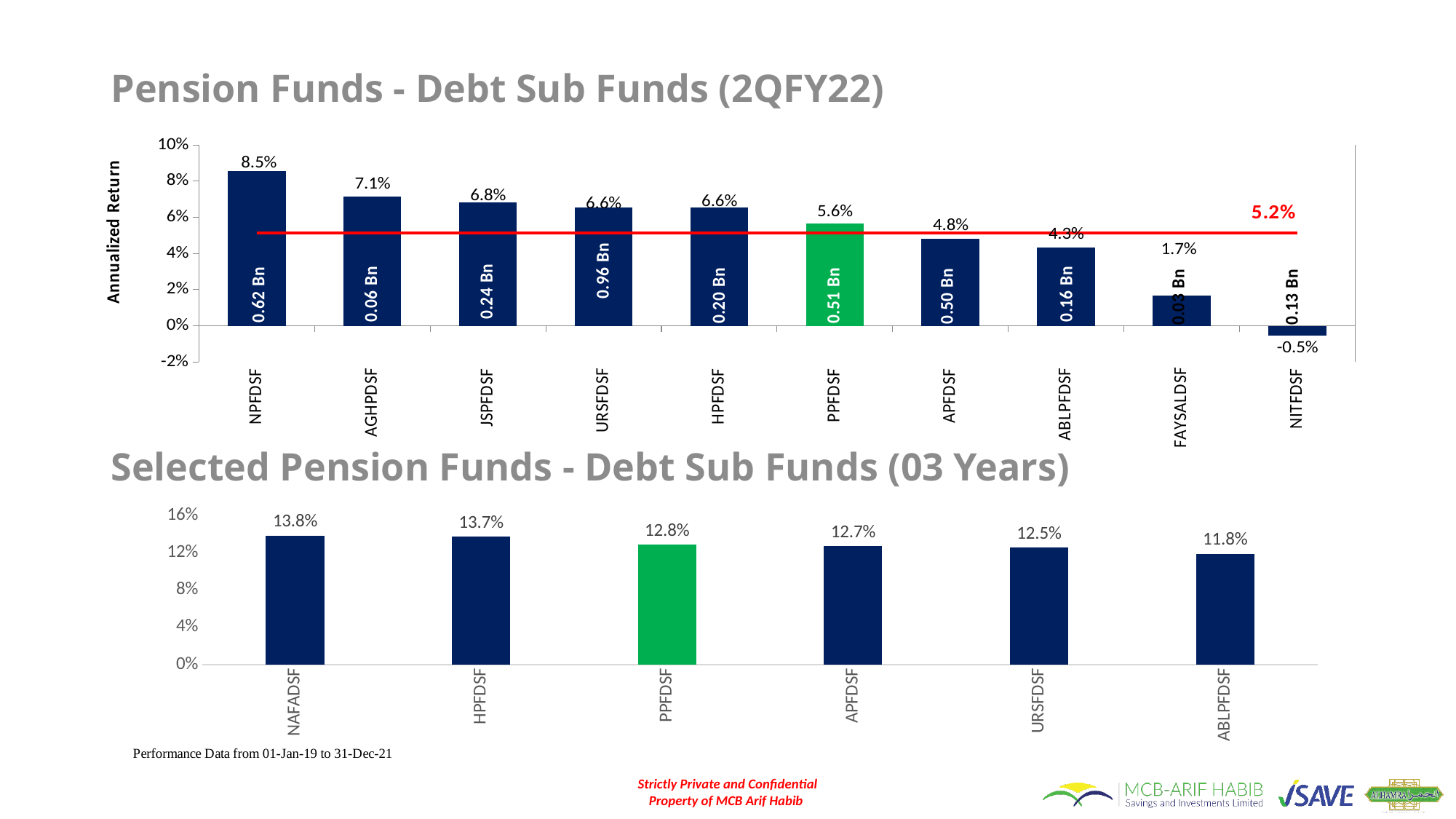
In the 'Selected Pension Funds - Debt Sub Funds (03 Years)' chart, which fund has the highest value? NAFADSF In the 'Selected Pension Funds - Debt Sub Funds (03 Years)' chart, what is the value for PPFDSF? 12.8% In the 'Pension Funds - Debt Sub Funds (2QFY22)' chart, what is the annualized return for PPFDSF? 5.6% In the 'Pension Funds - Debt Sub Funds (2QFY22)' chart, what is the difference between the annualized returns of NPFDSF and AGHPDSF? 1.4% In the 'Pension Funds - Debt Sub Funds (2QFY22)' chart, what fund size is printed on the URSFDSF bar? 0.96 Bn In the 'Pension Funds - Debt Sub Funds (2QFY22)' chart, what value does the red horizontal line mark? 5.2% In the 'Pension Funds - Debt Sub Funds (2QFY22)' chart, which fund has the lowest annualized return? NITFDSF In the 'Pension Funds - Debt Sub Funds (2QFY22)' chart, what is the annualized return for NPFDSF? 8.5% In the 'Pension Funds - Debt Sub Funds (2QFY22)' chart, how many funds are shown? 10 In the 'Pension Funds - Debt Sub Funds (2QFY22)' chart, which fund has the highest annualized return? NPFDSF In the 'Selected Pension Funds - Debt Sub Funds (03 Years)' chart, what is the difference between NAFADSF and ABLPFDSF? 2.0% What kind of chart is the 'Selected Pension Funds - Debt Sub Funds (03 Years)' chart? Bar chart